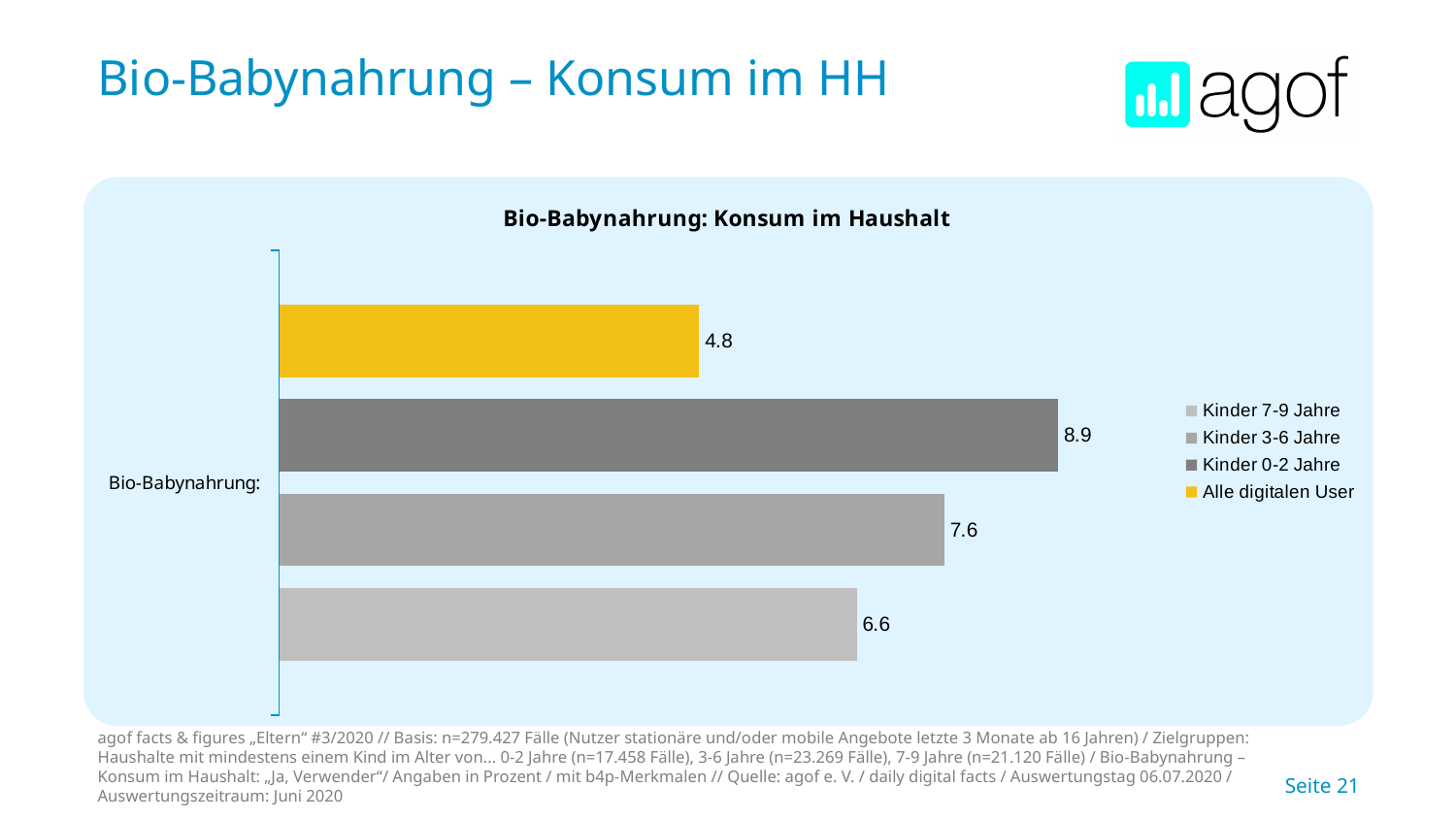
Which is larger, the value for Kinder 3-6 Jahre or Kinder 7-9 Jahre? Kinder 3-6 Jahre Which series has the lowest value? Alle digitalen User What is the difference between the values for Kinder 0-2 Jahre and Alle digitalen User? 4.1 What is the value for Alle digitalen User? 4.8 What is the difference between the values for Kinder 3-6 Jahre and Kinder 7-9 Jahre? 1.0 What is the value for Kinder 3-6 Jahre? 7.6 How many series does the legend list? 4 What is the value for Kinder 7-9 Jahre? 6.6 What kind of chart is shown on the slide? bar chart What is the value for Kinder 0-2 Jahre? 8.9 What is the title of the chart? Bio-Babynahrung: Konsum im Haushalt Which series has the highest value? Kinder 0-2 Jahre